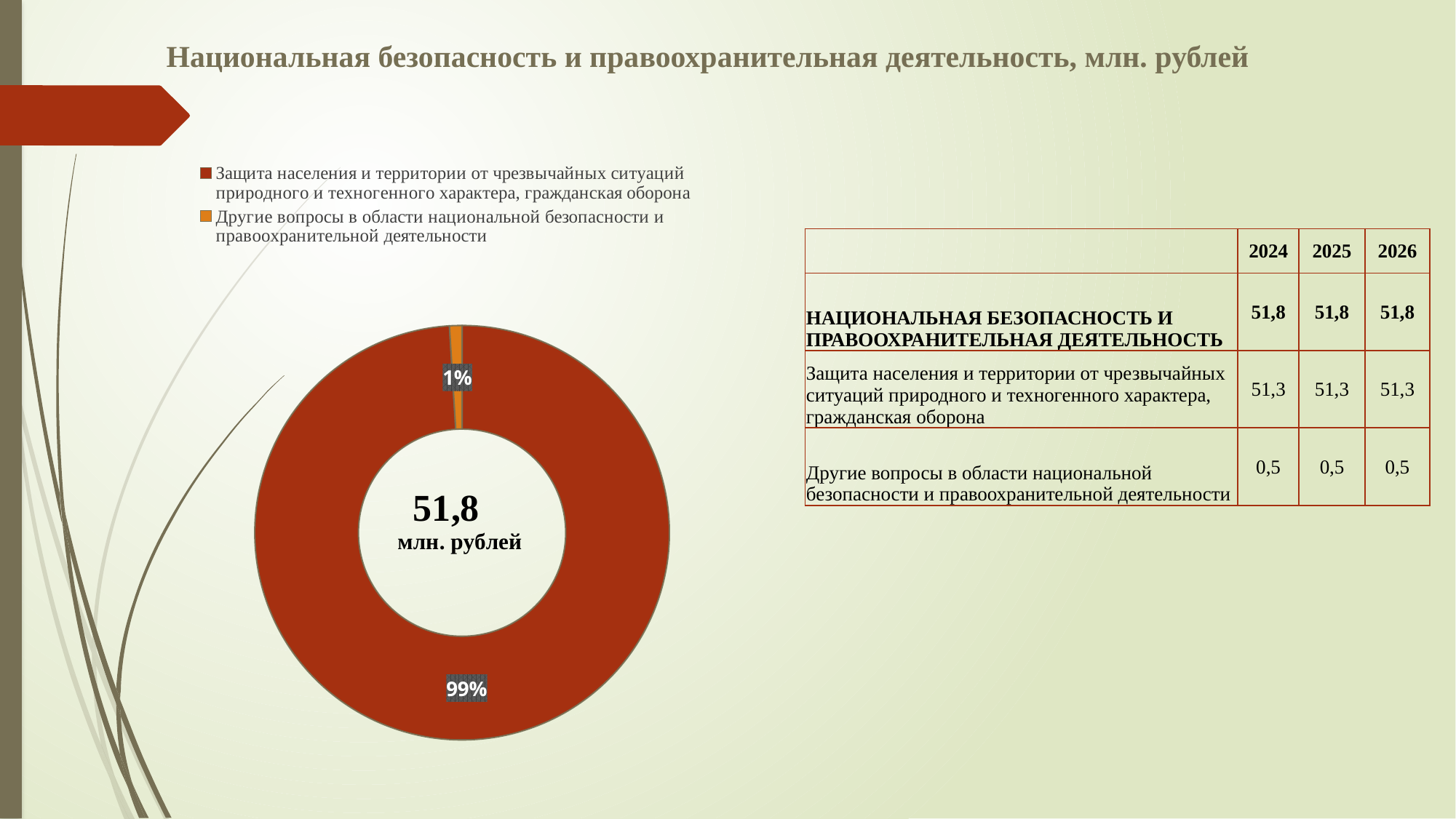
What total value is printed in the centre of the doughnut chart? 51,8 млн. рублей What is the difference in percentage points between the two slices of the doughnut chart? 98 percentage points What colour is the slice for "Другие вопросы в области национальной безопасности и правоохранительной деятельности"? Orange What is the title of the slide containing the doughnut chart? Национальная безопасность и правоохранительная деятельность, млн. рублей How many slices does the doughnut chart have? 2 What share of the doughnut chart is labelled for "Защита населения и территории от чрезвычайных ситуаций природного и техногенного характера, гражданская оборона"? 99% Which category has the largest slice in the doughnut chart? Защита населения и территории от чрезвычайных ситуаций природного и техногенного характера, гражданская оборона How many entries does the chart legend list? 2 What kind of chart is shown on the slide? Doughnut (pie) chart Which slice is larger: "Защита населения и территории..." or "Другие вопросы в области национальной безопасности..."? Защита населения и территории от чрезвычайных ситуаций природного и техногенного характера, гражданская оборона What share of the doughnut chart is labelled for "Другие вопросы в области национальной безопасности и правоохранительной деятельности"? 1% Which category has the smallest slice in the doughnut chart? Другие вопросы в области национальной безопасности и правоохранительной деятельности